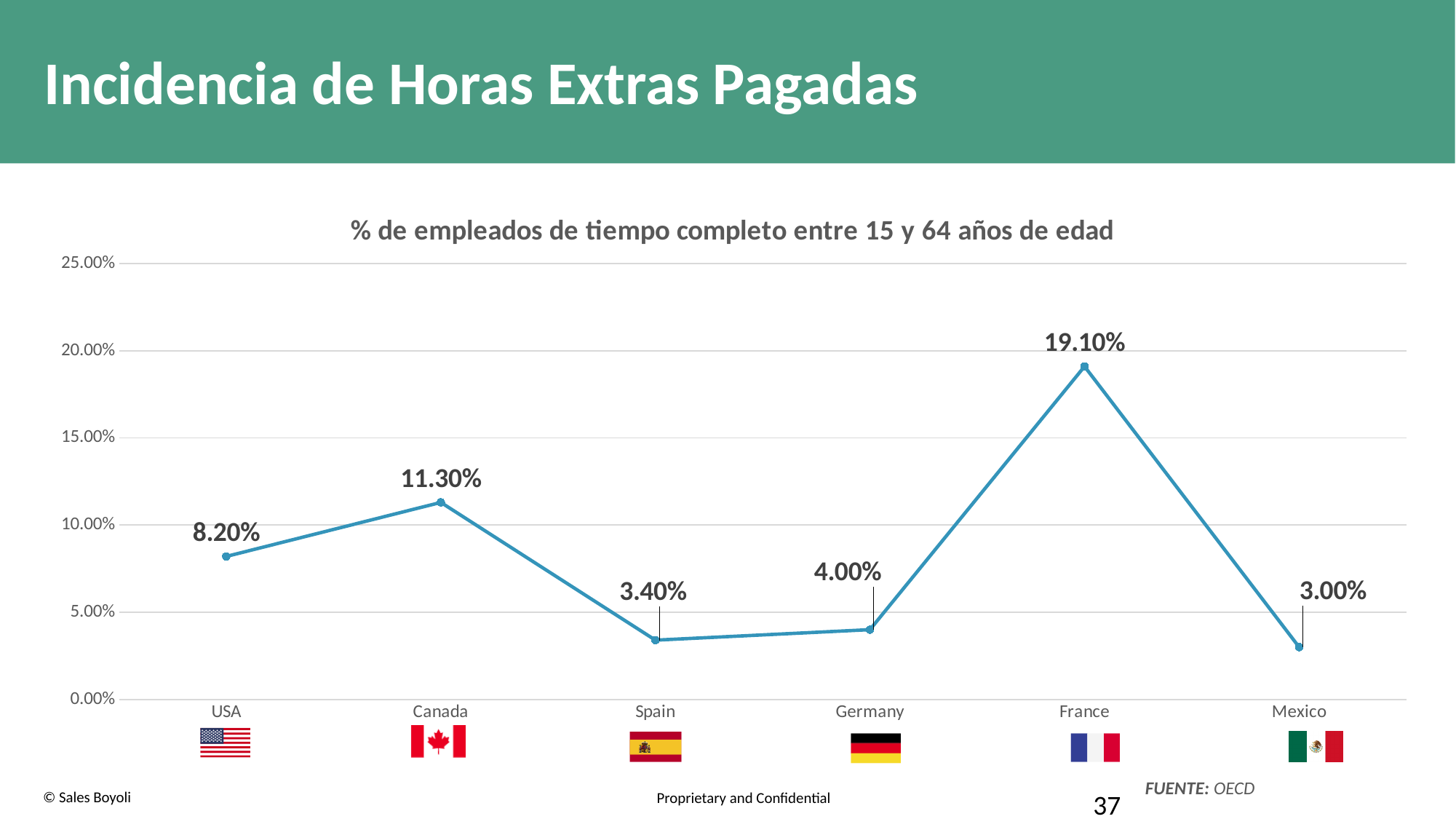
Is the value for Canada greater or less than 10.00%? greater How many countries are plotted on the chart? 6 Does the value rise or fall from Canada to Spain? Fall Which country has the lowest value? Mexico What is the title of the chart? % de empleados de tiempo completo entre 15 y 64 años de edad What kind of chart is shown on the slide? Line chart What is the value for Canada? 11.30% What is the value for France? 19.10% Which country has the highest value? France What is the value for Mexico? 3.00% Which has a larger value, Spain or Germany? Germany What is the difference between the values for France and USA? 10.90%